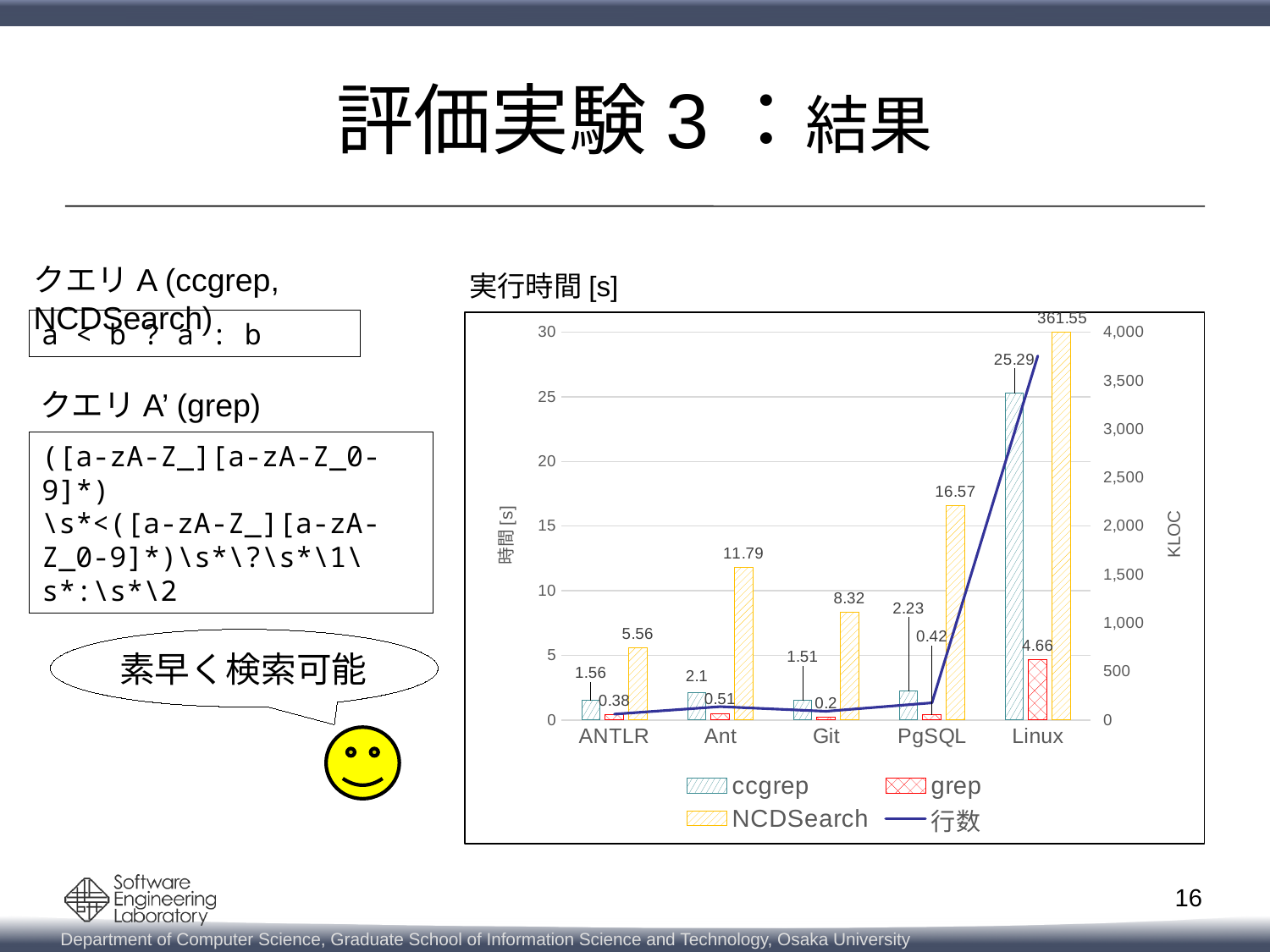
How many categories are shown on the x axis? 5 What is the NCDSearch value for Ant? 11.79 What is the NCDSearch value for PgSQL? 16.57 What kind of chart is this? Combined bar and line chart Which is larger for Ant: the ccgrep value or the NCDSearch value? NCDSearch What is the ccgrep value for Linux? 25.29 How many series does the legend list? 4 Which category has the lowest grep value? Git What is the label of the secondary (right) vertical axis? KLOC What is the difference between the NCDSearch and ccgrep values for PgSQL? 14.34 What is the grep value for Git? 0.2 Which category has the highest ccgrep value? Linux